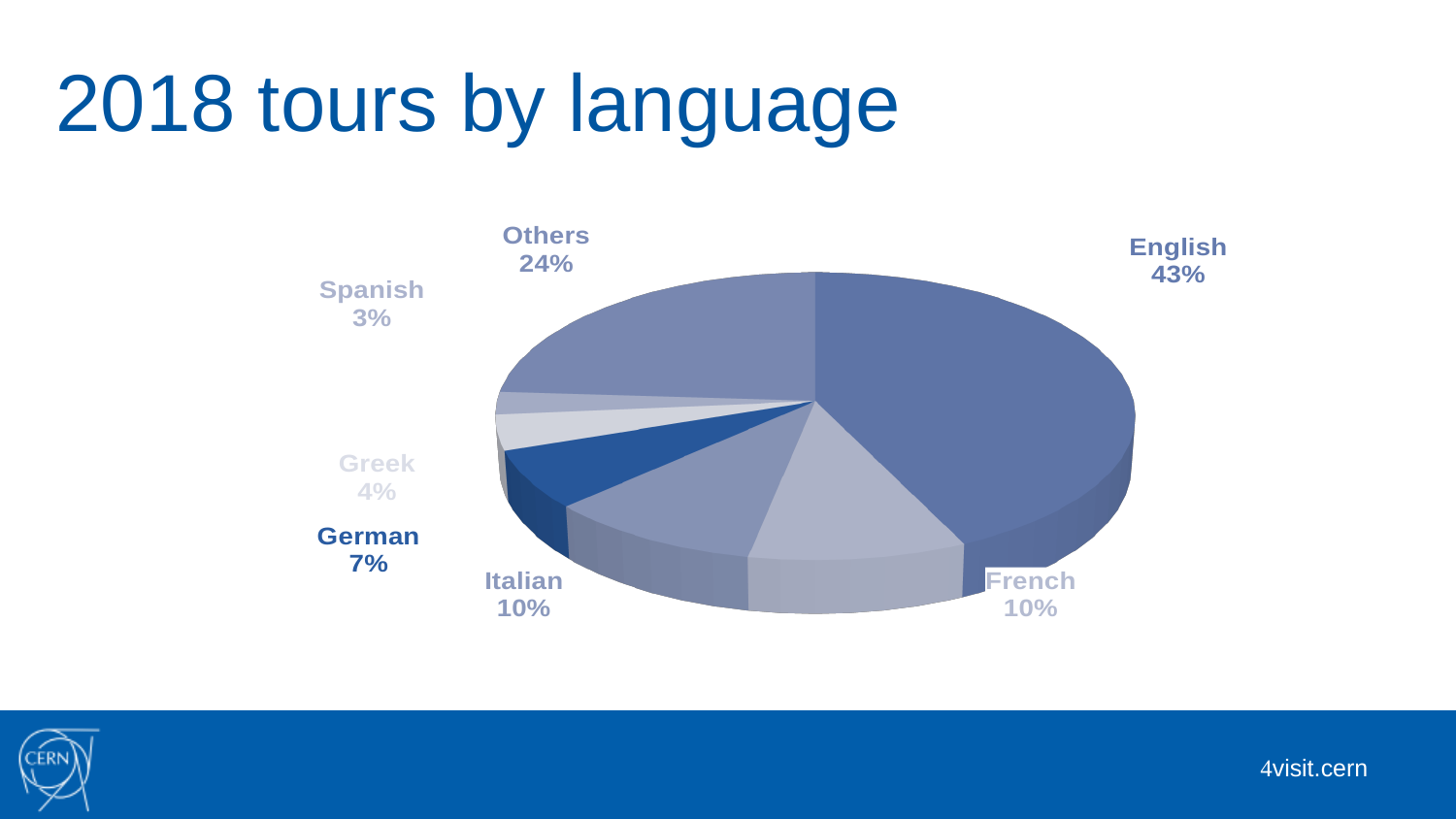
Which has a larger share of tours, German or Greek? German What is the title of the chart on the slide? 2018 tours by language What kind of chart is shown on the slide? Pie chart What share of tours were given in German? 7% Which language has the smallest share of tours? Spanish What is the combined share of French and Italian tours? 20% What percentage of tours does the Others slice represent? 24% Which language has the largest share of tours? English What percentage of tours were in Greek? 4% How many slices does the pie chart have? 7 What share of 2018 tours were in English? 43% How many percentage points larger is the English share than the Others share? 19